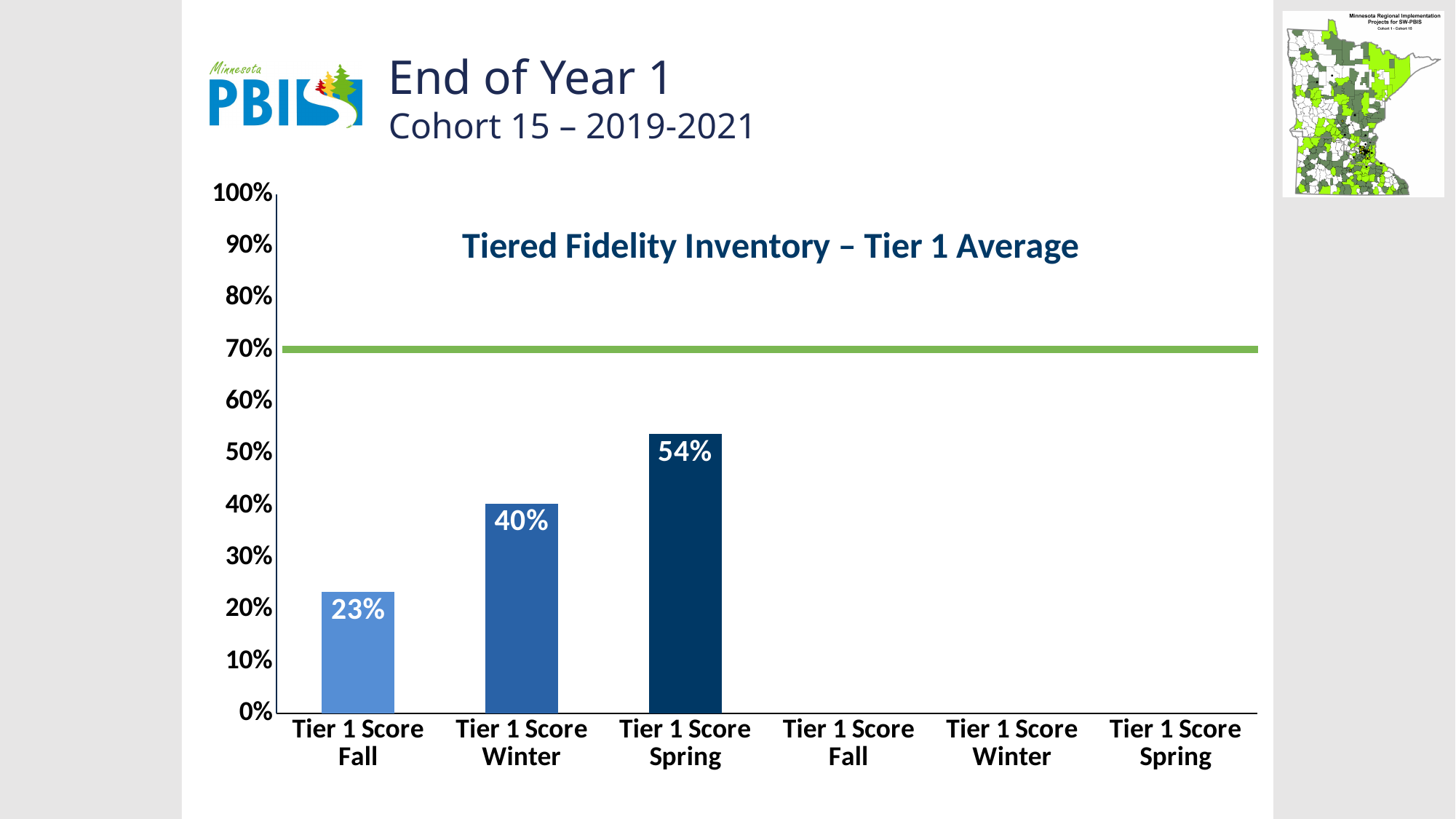
How many category labels are shown on the x axis? 6 Which is larger, the Tier 1 Score Winter bar or the Tier 1 Score Spring bar? Tier 1 Score Spring What is the value of the Tier 1 Score Winter bar? 40% Is the value for Tier 1 Score Spring greater or less than 70%? less Do the plotted bar values rise or fall from Fall to Spring? rise Which category has the lowest plotted bar? Tier 1 Score Fall What is the value of the first bar, Tier 1 Score Fall? 23% What is the difference between the Tier 1 Score Spring bar and the Tier 1 Score Fall bar? 31% Which category has the highest bar? Tier 1 Score Spring What kind of chart is shown on the slide? bar chart What is the value of the Tier 1 Score Spring bar? 54% What is the difference between the Tier 1 Score Winter bar and the Tier 1 Score Fall bar? 17%